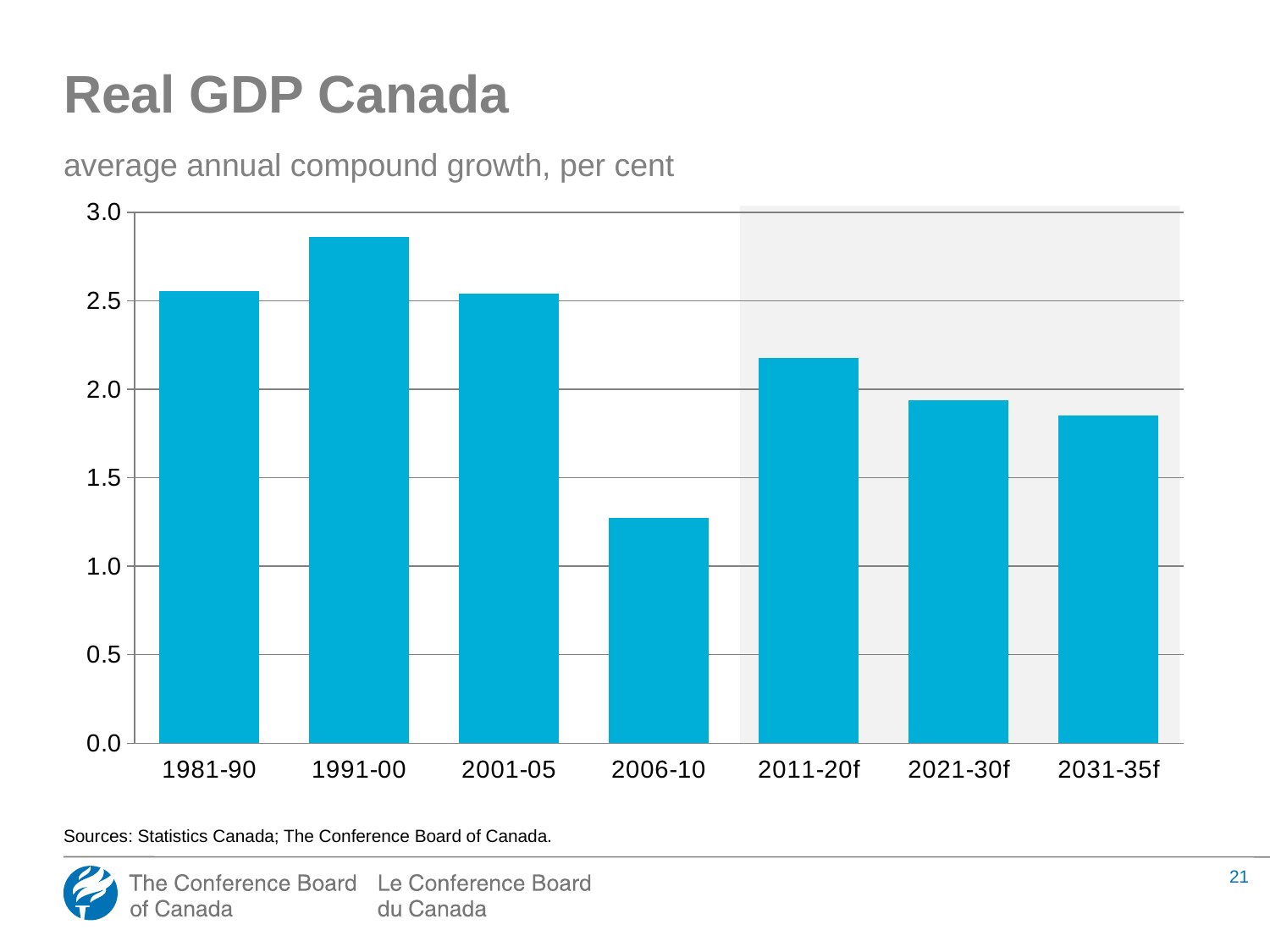
Is the value for 2011-20f greater or less than 2.0? greater How many periods are shown on the x axis of the chart? 7 Is the value for 1991-00 greater or less than 2.5? greater Which period has the highest real GDP growth in the chart? 1991-00 Which is larger, the value for 1991-00 or the value for 2006-10? 1991-00 Which is larger, the value for 2011-20f or the value for 2021-30f? 2011-20f What is the title of the chart on the slide? Real GDP Canada What kind of chart is shown on the slide? bar chart Is the value for 2006-10 greater or less than 1.5? less Across the three forecast periods 2011-20f, 2021-30f and 2031-35f, do the values rise or fall? fall Which period has the lowest real GDP growth in the chart? 2006-10